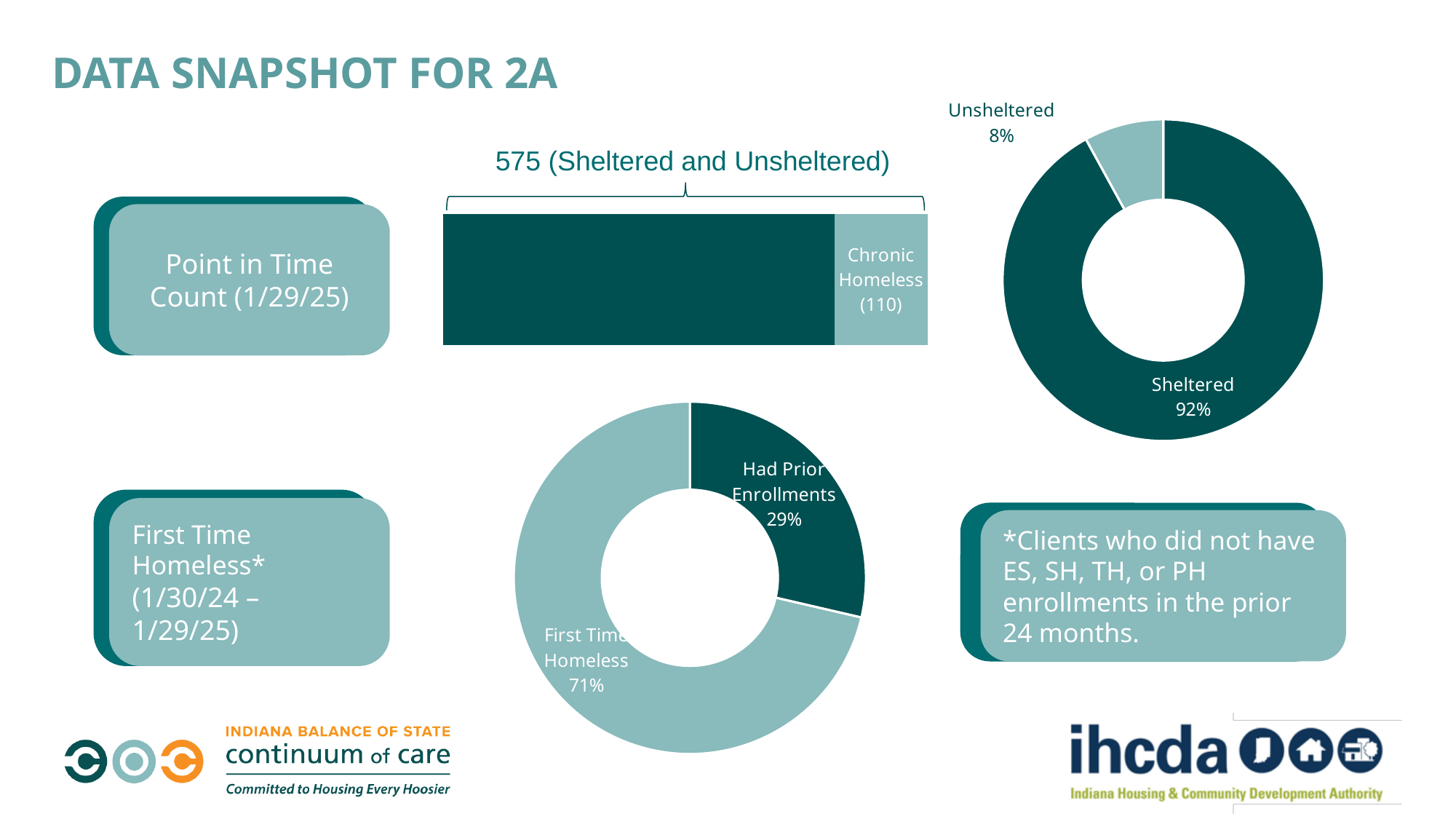
What kind of chart is used at the top right of the slide to show Sheltered and Unsheltered? Donut (pie) chart In the horizontal bar at the top centre of the slide, how many of the 575 are not Chronic Homeless? 465 In the donut chart at the bottom centre of the slide, what share is First Time Homeless? 71% In the donut chart at the bottom centre of the slide, what share is Had Prior Enrollments? 29% In the donut chart at the top right of the slide, what share is Unsheltered? 8% In the horizontal bar at the top centre of the slide, what is the value labelled for Chronic Homeless? 110 In the donut chart at the bottom centre of the slide, how many slices are there? 2 In the donut chart at the top right of the slide, what share is Sheltered? 92% In the horizontal bar at the top centre of the slide, what total is shown above the bar for Sheltered and Unsheltered? 575 In the donut chart at the top right of the slide, which slice is larger, Sheltered or Unsheltered? Sheltered In the donut chart at the bottom centre of the slide, which slice is the smallest? Had Prior Enrollments In the donut chart at the top right of the slide, how many percentage points larger is Sheltered than Unsheltered? 84